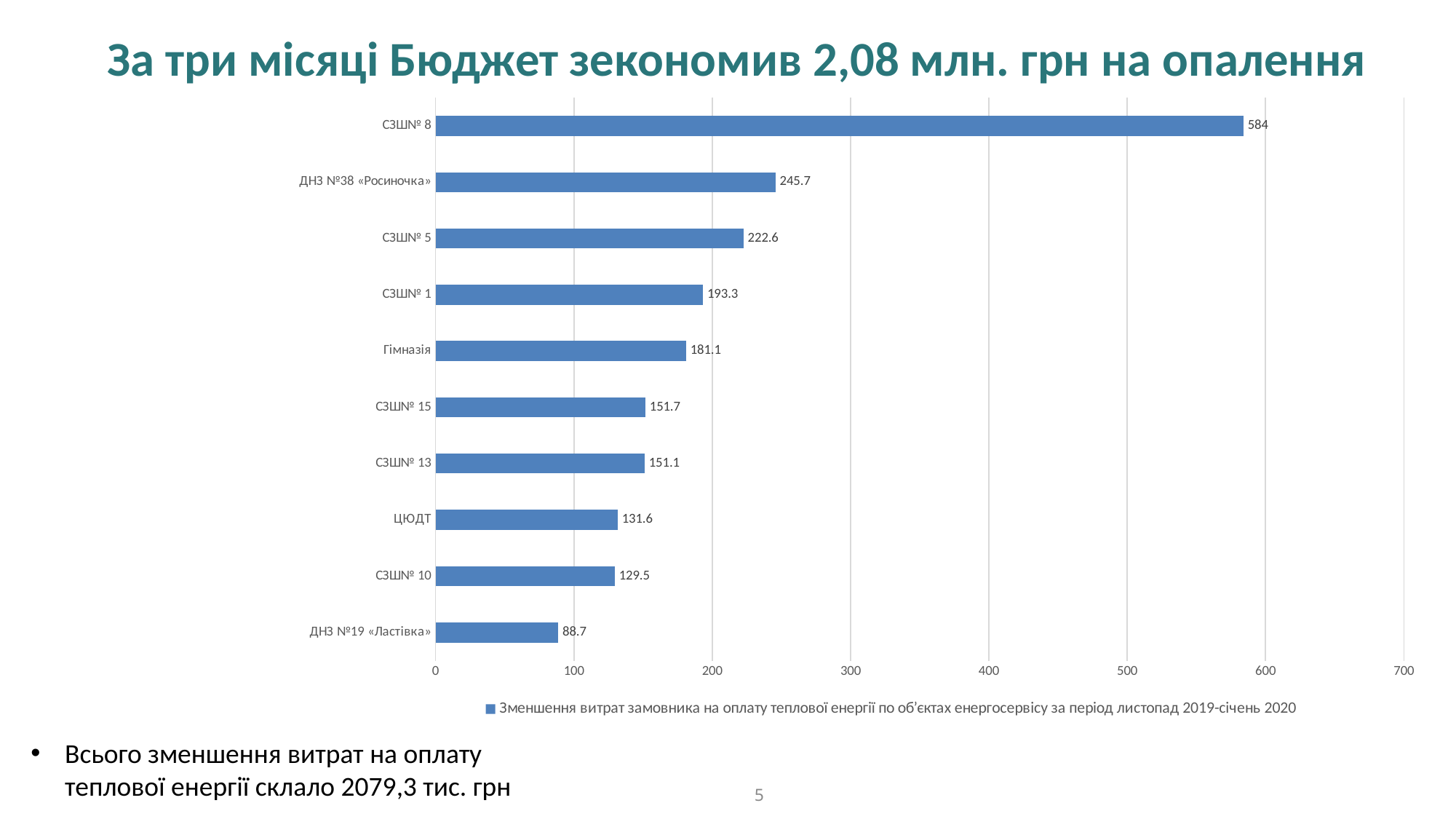
What is the difference between the values for СЗШ№ 8 and ДНЗ №38 «Росиночка»? 338.3 Which has a larger value, СЗШ№ 1 or Гімназія? СЗШ№ 1 What is the value for ДНЗ №38 «Росиночка»? 245.7 Which category has the highest value? СЗШ№ 8 What is the difference between the values for СЗШ№ 5 and СЗШ№ 1? 29.3 What is the value for СЗШ№ 8? 584 What is the value for ЦЮДТ? 131.6 Is the value for СЗШ№ 8 greater or less than 500? greater Which category has the lowest value? ДНЗ №19 «Ластівка» How many categories are shown in the chart? 10 What kind of chart is shown on the slide? bar chart What is the value for Гімназія? 181.1